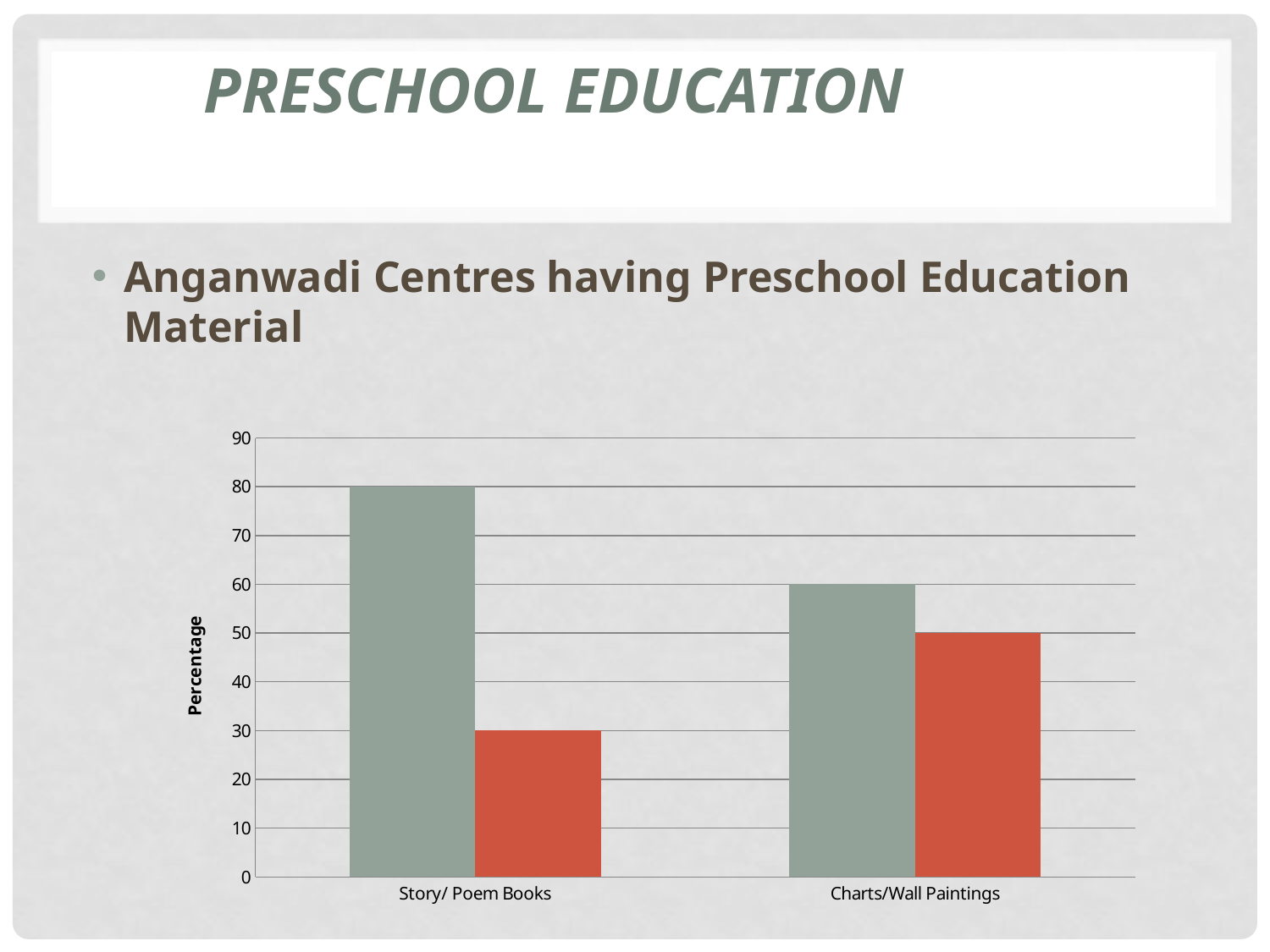
Which category has the shortest bar in the chart? Story/ Poem Books What is the value of the red bar for Charts/Wall Paintings? 50 Which is larger: the red bar for Story/ Poem Books or the red bar for Charts/Wall Paintings? Charts/Wall Paintings What kind of chart is shown on the slide? bar chart Which category has the tallest bar in the chart? Story/ Poem Books What is the value of the grey bar for Story/ Poem Books? 80 What is the difference between the grey bar and the red bar for Story/ Poem Books? 50 What is the value of the red bar for Story/ Poem Books? 30 What is the difference between the grey bar and the red bar for Charts/Wall Paintings? 10 What is the value of the grey bar for Charts/Wall Paintings? 60 What is the label of the vertical axis of the chart? Percentage How many categories are shown on the x axis of the chart? 2